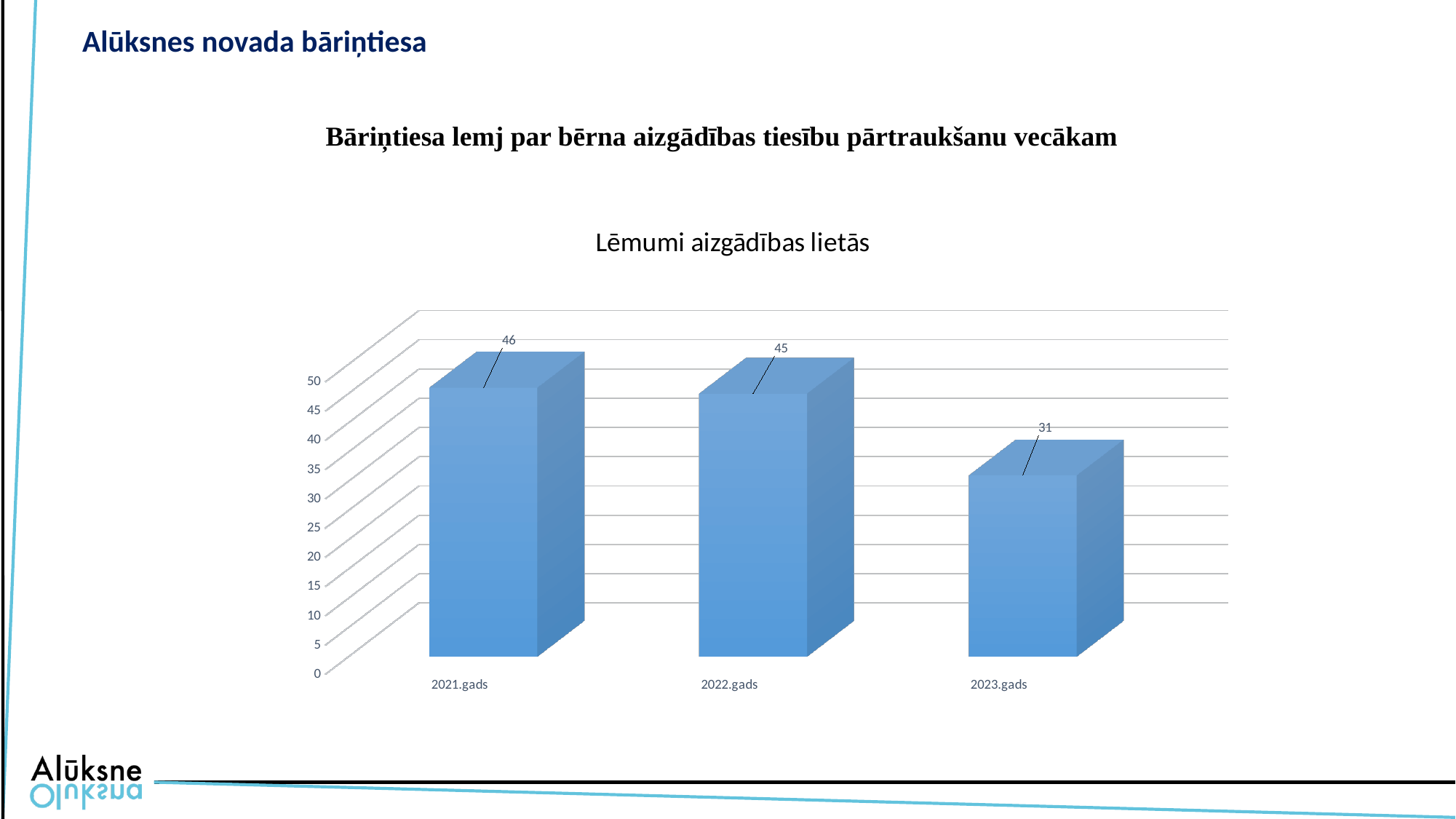
What is the value for 2023.gads? 31 What is the title of the chart? Lēmumi aizgādības lietās Is the value for 2023.gads greater or less than 35? less How many years are shown on the chart? 3 What is the difference between the values for 2022.gads and 2023.gads? 14 What is the difference between the values for 2021.gads and 2023.gads? 15 Which is larger, the value for 2022.gads or the value for 2023.gads? 2022.gads Which year has the highest value? 2021.gads What is the value for 2021.gads? 46 Which year has the lowest value? 2023.gads What kind of chart is shown on the slide? bar chart What is the value for 2022.gads? 45